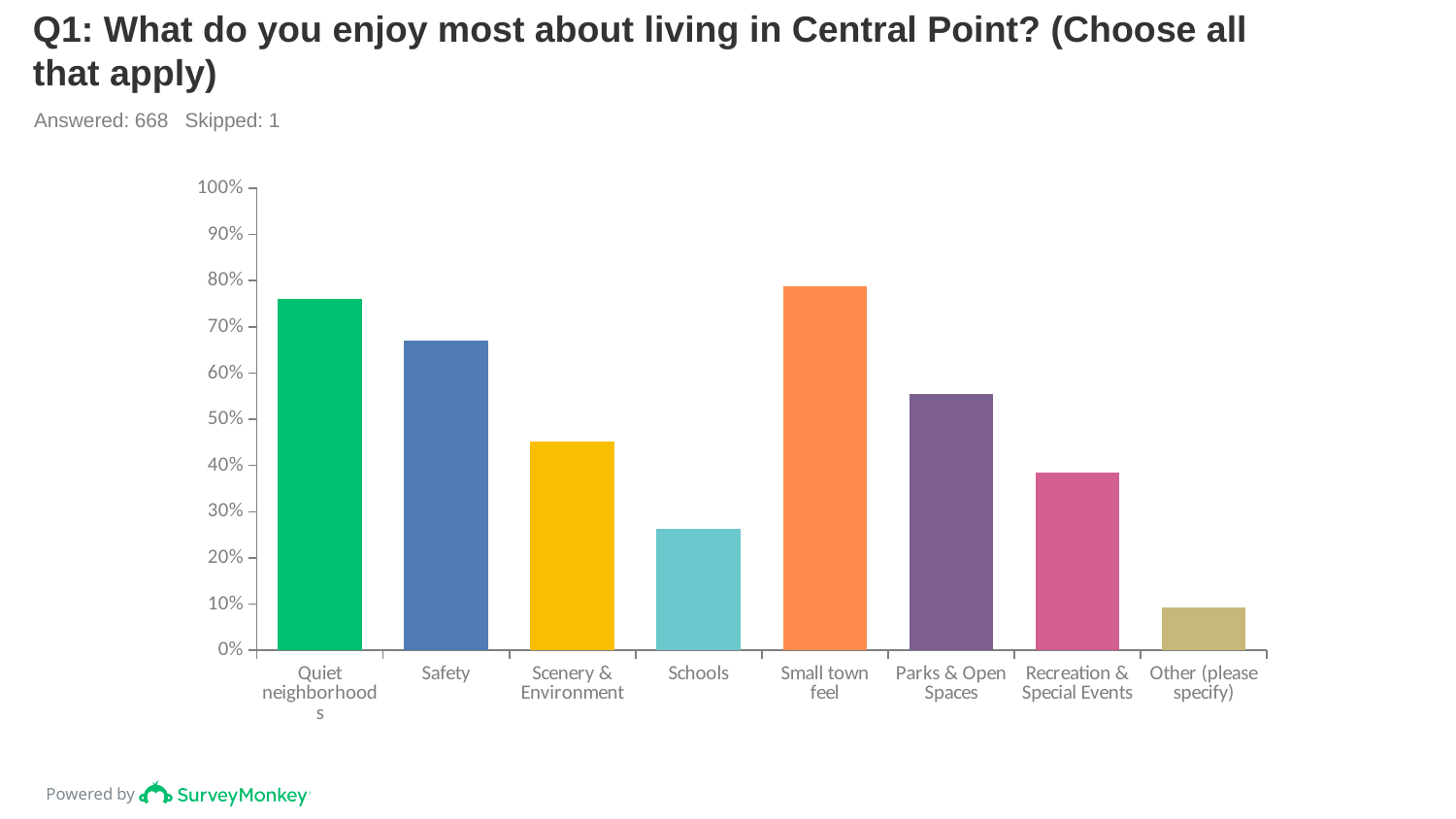
Is the value for Safety greater or less than 60%? greater Which category has the highest value in the chart? Small town feel Which is larger, the value for Schools or the value for Parks & Open Spaces? Parks & Open Spaces Is the value for Other (please specify) greater or less than 20%? less Which category has the lowest value in the chart? Other (please specify) How many categories are shown on the x axis of the chart? 8 Which is larger, the value for Safety or the value for Scenery & Environment? Safety Is the value for Scenery & Environment greater or less than 50%? less How many respondents answered the question shown in the chart title? 668 What kind of chart is shown on the slide? bar chart